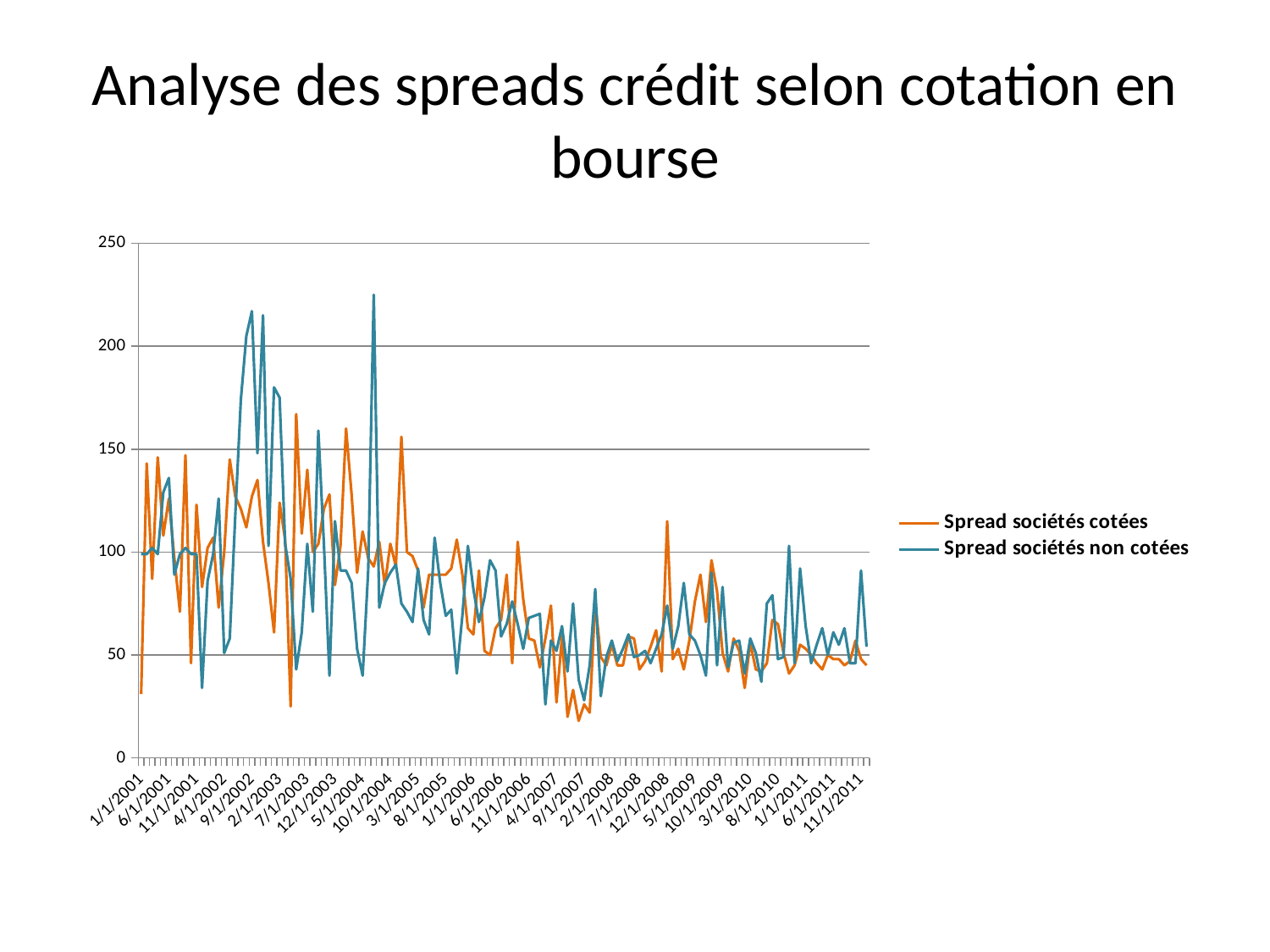
Is the highest value of 'Spread sociétés cotées' greater or less than 200? less Is the value for 'Spread sociétés non cotées' at 1/1/2001 greater or less than 50? greater Which colour is used for the 'Spread sociétés non cotées' line? blue Is the lowest value of 'Spread sociétés cotées' (around 9/1/2007) greater or less than 50? less What are the two series named in the legend? Spread sociétés cotées; Spread sociétés non cotées How many series does the legend list? 2 Which series reaches the highest peak on the chart? Spread sociétés non cotées Overall, do the spread values rise or fall from 2002-2003 to 2011? fall What kind of chart is shown on the slide? line chart What is the highest value shown on the vertical axis? 250